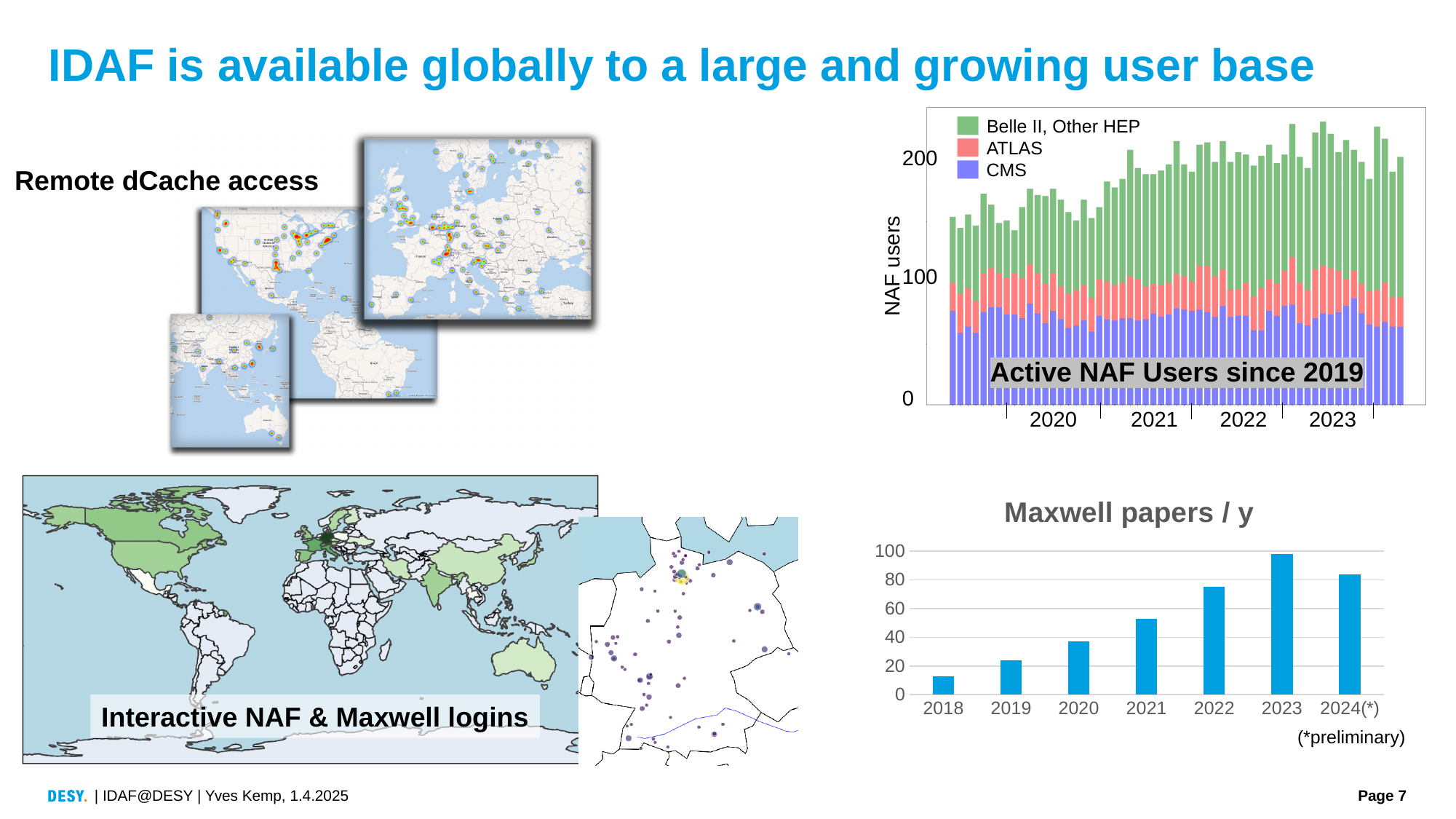
How many years are shown on the x axis of the 'Maxwell papers / y' chart? 7 In the 'Maxwell papers / y' chart, is the value for 2021 greater or less than 60? less In the 'Maxwell papers / y' chart, which year has the highest bar? 2023 What kind of chart is the 'Maxwell papers / y' chart? bar chart In the 'Maxwell papers / y' chart, do the values rise or fall from 2018 to 2023? rise In the 'Maxwell papers / y' chart, which year has the lowest bar? 2018 In the 'Maxwell papers / y' chart, which is larger, the value for 2022 or the value for 2020? 2022 In the 'Active NAF Users since 2019' chart, which series is shown in green? Belle II, Other HEP What is the y-axis label of the 'Active NAF Users since 2019' chart? NAF users How many series does the legend of the 'Active NAF Users since 2019' chart list? 3 In the 'Maxwell papers / y' chart, is the value for 2023 greater or less than 80? greater In the 'Maxwell papers / y' chart, is the value for 2018 greater or less than 20? less